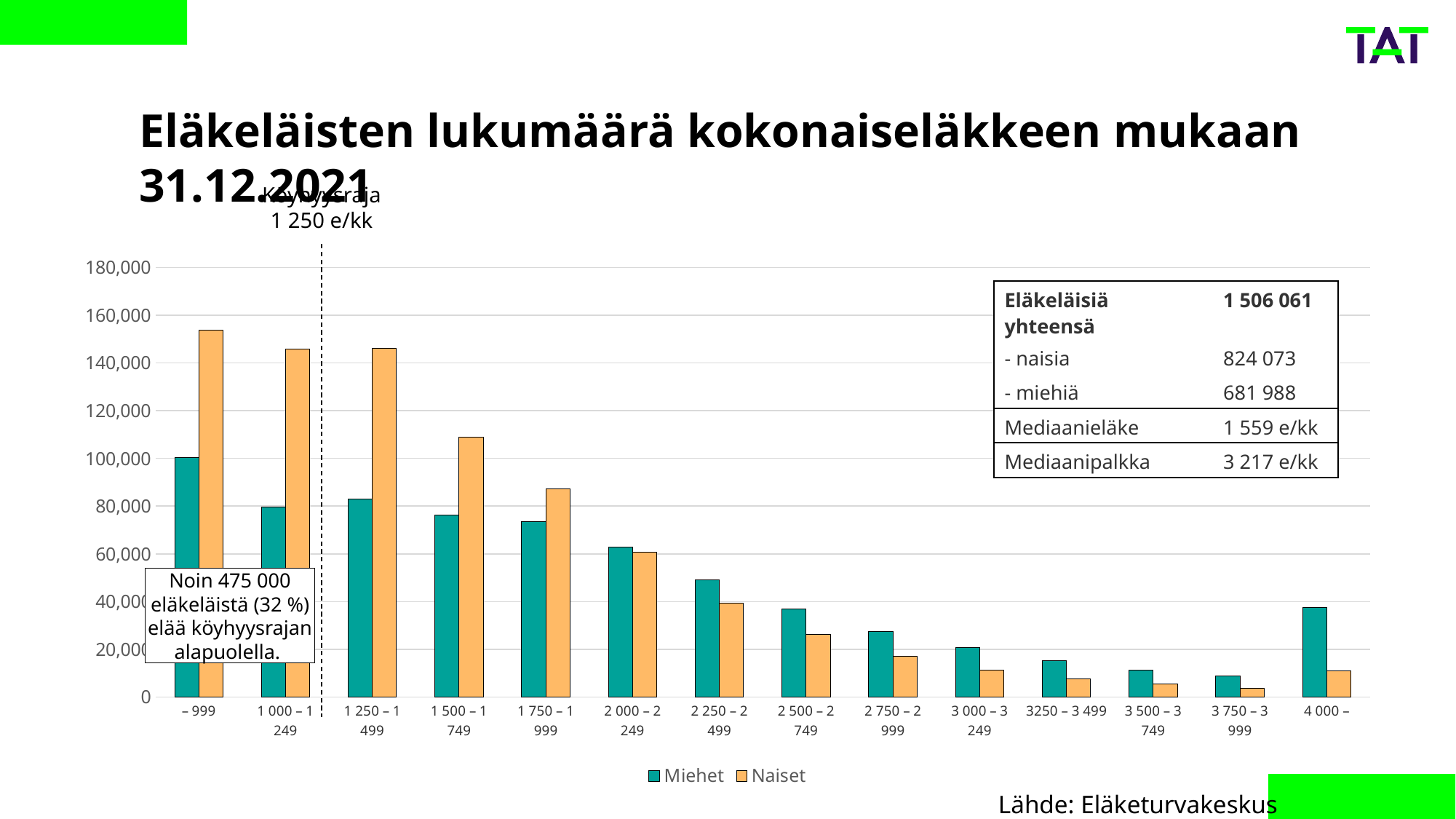
Is the value for Miehet in the 2 250 – 2 499 category greater or less than 60,000? less How many pension-range categories are shown on the x axis? 14 How many series does the legend list? 2 Is the value for Naiset in the 1 500 – 1 749 category greater or less than 100,000? greater Which category has the lowest value for Miehet? 3 750 – 3 999 What kind of chart is shown on the slide? bar chart What are the two series named in the legend? Miehet and Naiset Do the Naiset values rise or fall from the 1 250 – 1 499 category to the 3 750 – 3 999 category? fall Which category has the highest value for Naiset? – 999 Which category has the highest value for Miehet? – 999 In the 4 000 – category, which series has the larger value, Miehet or Naiset? Miehet Is the value for Naiset in the – 999 category greater or less than 140,000? greater